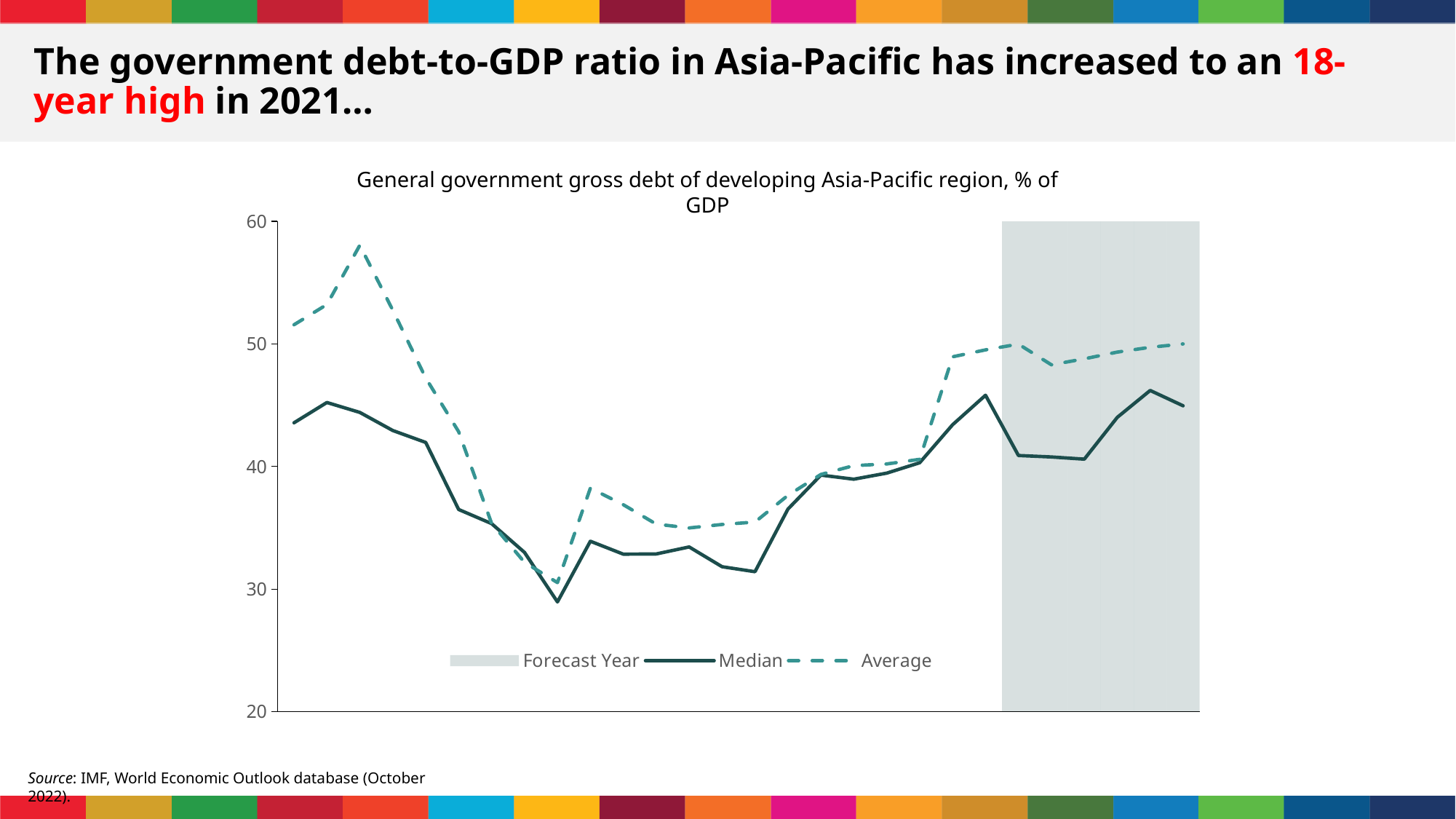
At the left end of the chart, which line is higher, Median or Average? Average What kind of chart is shown on the slide? line chart Is the highest point of the Average line greater or less than 50? greater What does the shaded area on the right of the chart represent, according to the legend? Forecast Year Is the value of the Average line at the right end of the chart greater or less than 40? greater How many entries does the chart legend list? 3 What is the title of the chart? General government gross debt of developing Asia-Pacific region, % of GDP What is the highest value shown on the vertical axis? 60 Is the lowest point of the Median line greater or less than 40? less In the shaded forecast area, which line is higher, Median or Average? Average Which line reaches a higher peak, Median or Average? Average